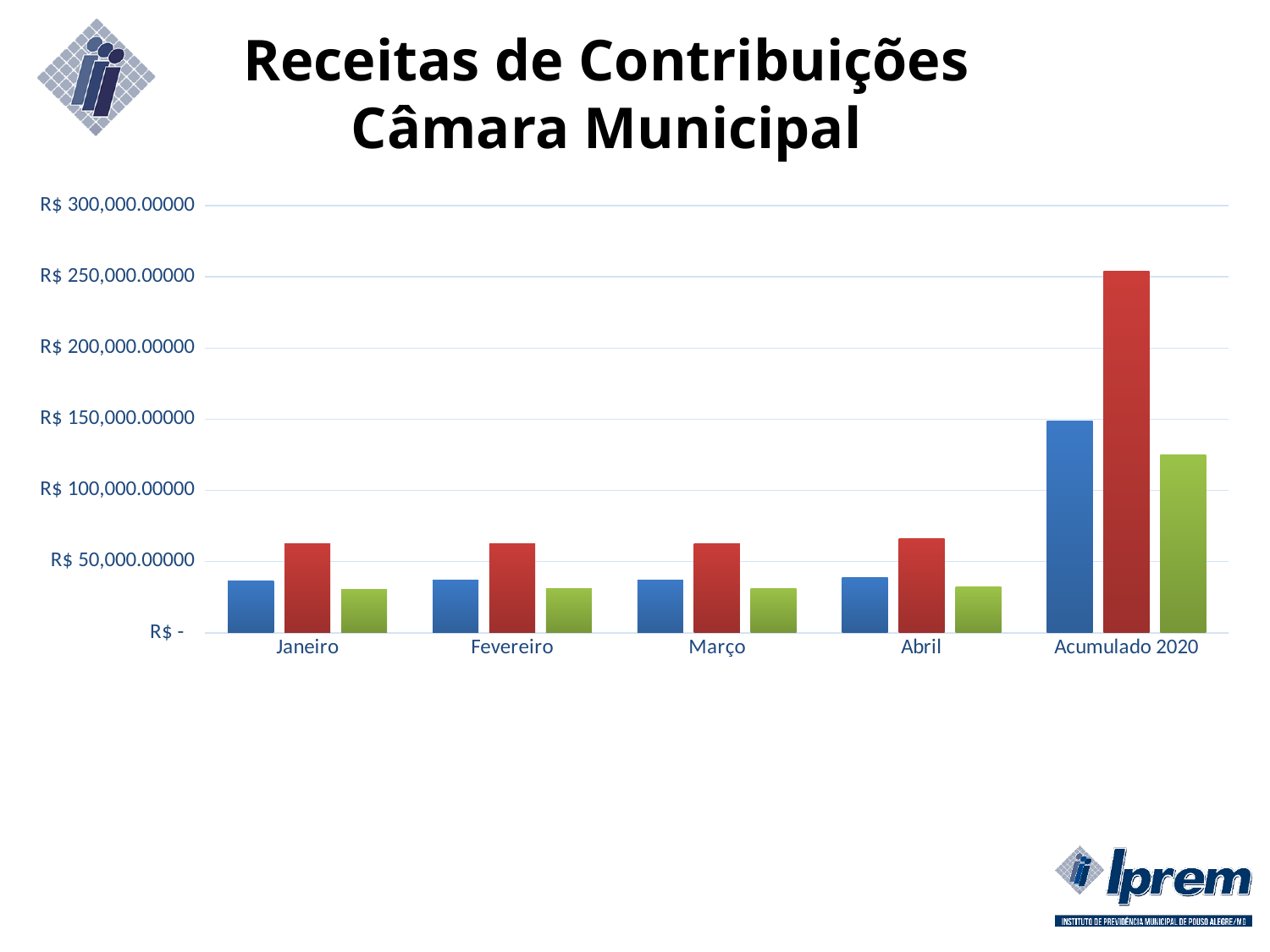
Which category has the tallest red bar in the chart? Acumulado 2020 What kind of chart is shown on the slide? Bar chart What is the title of the chart on the slide? Receitas de Contribuições Câmara Municipal Is the value of the blue bar for Janeiro greater or less than R$ 50,000.00000? less How many categories are shown on the x axis of the chart? 5 Is the value of the red bar for Março greater or less than R$ 50,000.00000? greater Is the value of the red bar for Acumulado 2020 greater or less than R$ 200,000.00000? greater What is the highest value labelled on the vertical axis of the chart? R$ 300,000.00000 Which category has the tallest blue bar in the chart? Acumulado 2020 In the Abril category, which bar is taller, the red bar or the green bar? The red bar How many bars are plotted for each category in the chart? 3